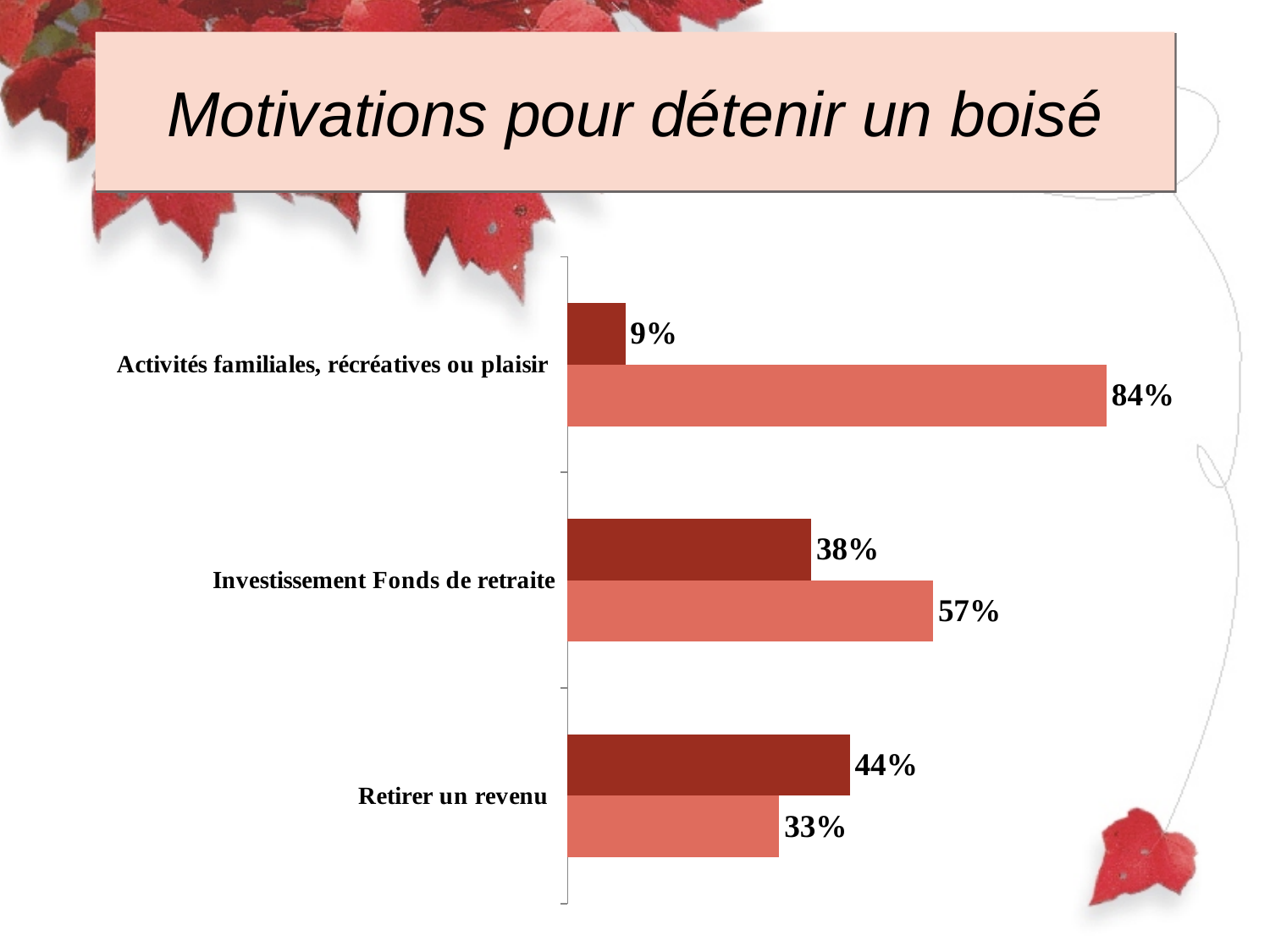
What is the value of the dark red bar for 'Activités familiales, récréatives ou plaisir'? 9% For 'Retirer un revenu', which bar is larger, the dark red or the light red? dark red Which category has the highest light red bar? Activités familiales, récréatives ou plaisir What kind of chart is shown on the slide? bar chart How many categories are shown on the chart? 3 What is the value of the light red bar for 'Retirer un revenu'? 33% What is the difference between the light red and dark red bars for 'Investissement Fonds de retraite'? 19% What is the value of the light red bar for 'Activités familiales, récréatives ou plaisir'? 84% What is the value of the dark red bar for 'Investissement Fonds de retraite'? 38% How many bars are plotted for each category? 2 Which category has the lowest dark red bar? Activités familiales, récréatives ou plaisir What is the title of the slide containing the chart? Motivations pour détenir un boisé